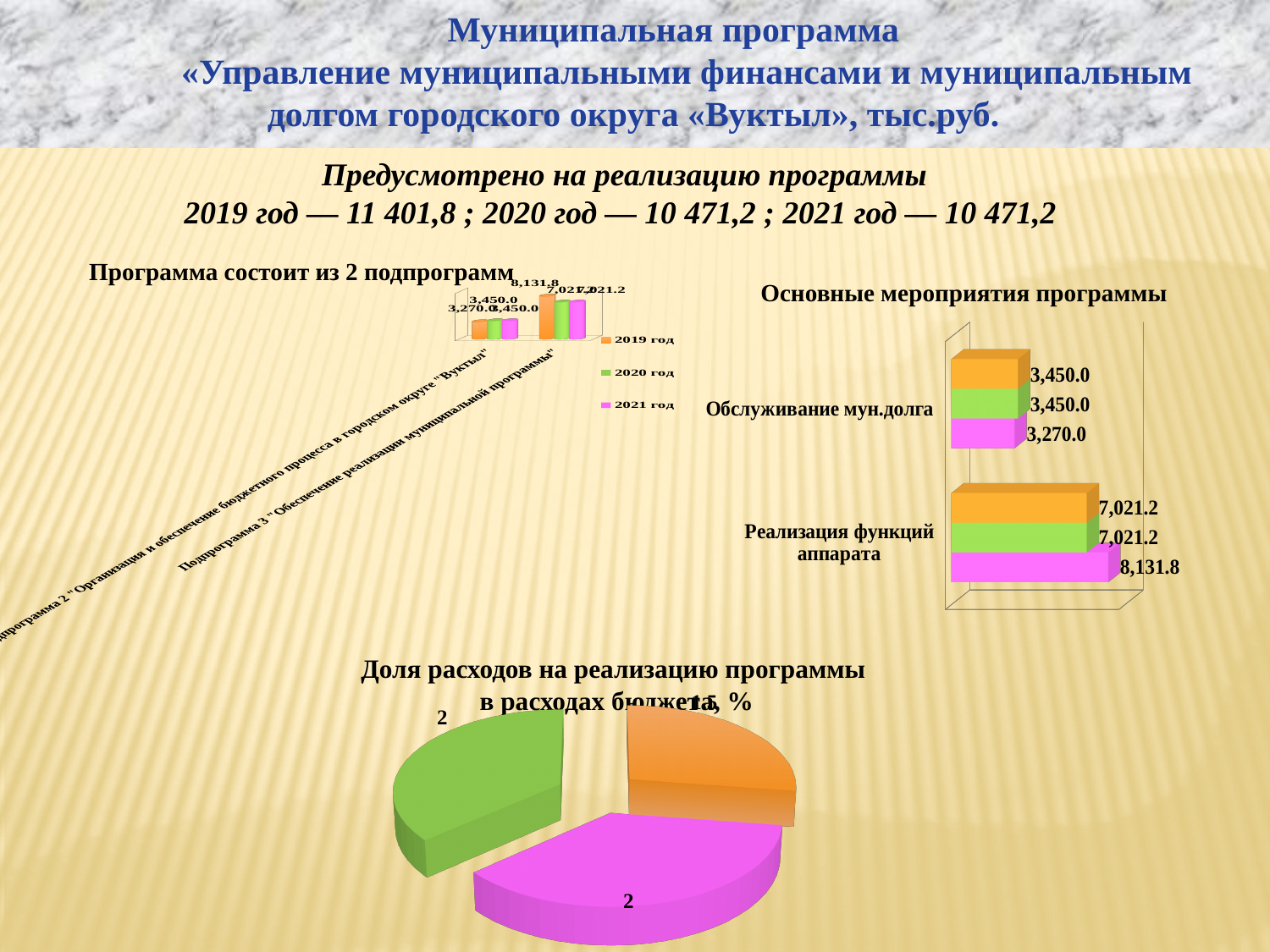
In the "Основные мероприятия программы" chart, what is the value of the pink bar for "Обслуживание мун.долга"? 3,270.0 In the "Основные мероприятия программы" chart, what is the difference between the pink bar (8,131.8) and the green bar (7,021.2) for "Реализация функций аппарата"? 1,110.6 How many slices does the "Доля расходов на реализацию программы в расходах бюджета, %" pie chart have? 3 In the small bar chart under "Программа состоит из 2 подпрограмм", what is the 2019 год value for Подпрограмма 3? 8,131.8 In the "Основные мероприятия программы" chart, what is the value of the pink bar for "Реализация функций аппарата"? 8,131.8 What kind of chart is the "Доля расходов на реализацию программы в расходах бюджета, %" chart? pie chart In the small bar chart under "Программа состоит из 2 подпрограмм", which is larger for Подпрограмма 3: the 2019 год value or the 2020 год value? 2019 год In the "Основные мероприятия программы" chart, how many categories are shown? 2 What kind of chart is the "Основные мероприятия программы" chart on the right? bar chart In the "Основные мероприятия программы" chart, what is the value of the orange bar for "Обслуживание мун.долга"? 3,450.0 How many series does the legend of the small bar chart under "Программа состоит из 2 подпрограмм" list? 3 In the "Основные мероприятия программы" chart, which category has the larger values, "Обслуживание мун.долга" or "Реализация функций аппарата"? Реализация функций аппарата